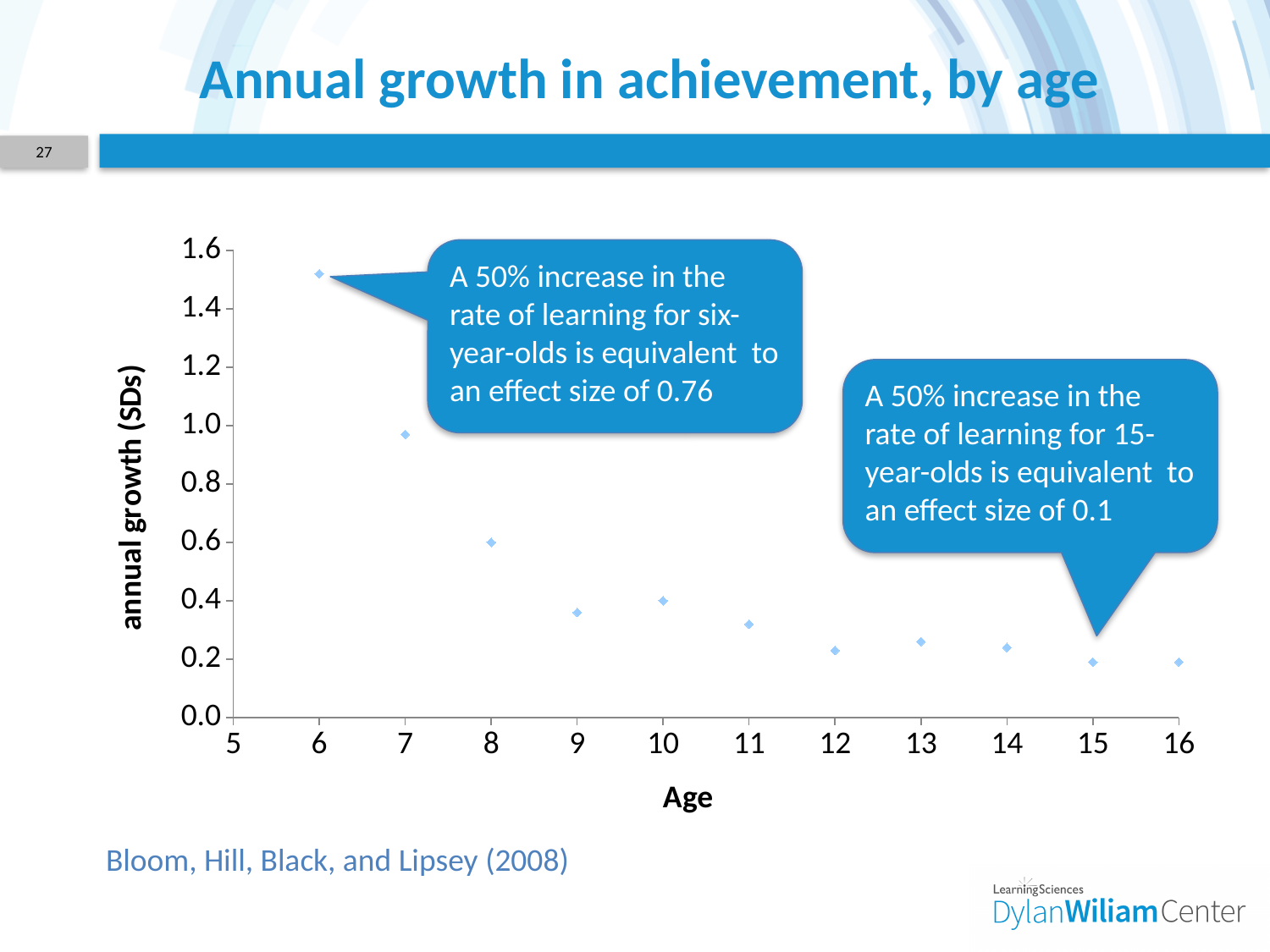
At which age is annual growth in achievement highest? 6 How many data points are plotted on the chart? 11 Is the value for age 8 greater or less than 0.8? less What kind of chart is shown on the slide? scatter chart What is the title of the chart on the slide? Annual growth in achievement, by age What is the label on the vertical axis of the chart? annual growth (SDs) Which has the larger annual growth, age 6 or age 7? age 6 Which has the larger annual growth, age 8 or age 9? age 8 Is the value for age 7 greater or less than 1.0? less Is the value for age 12 greater or less than 0.4? less Do the values generally rise or fall as age increases? fall